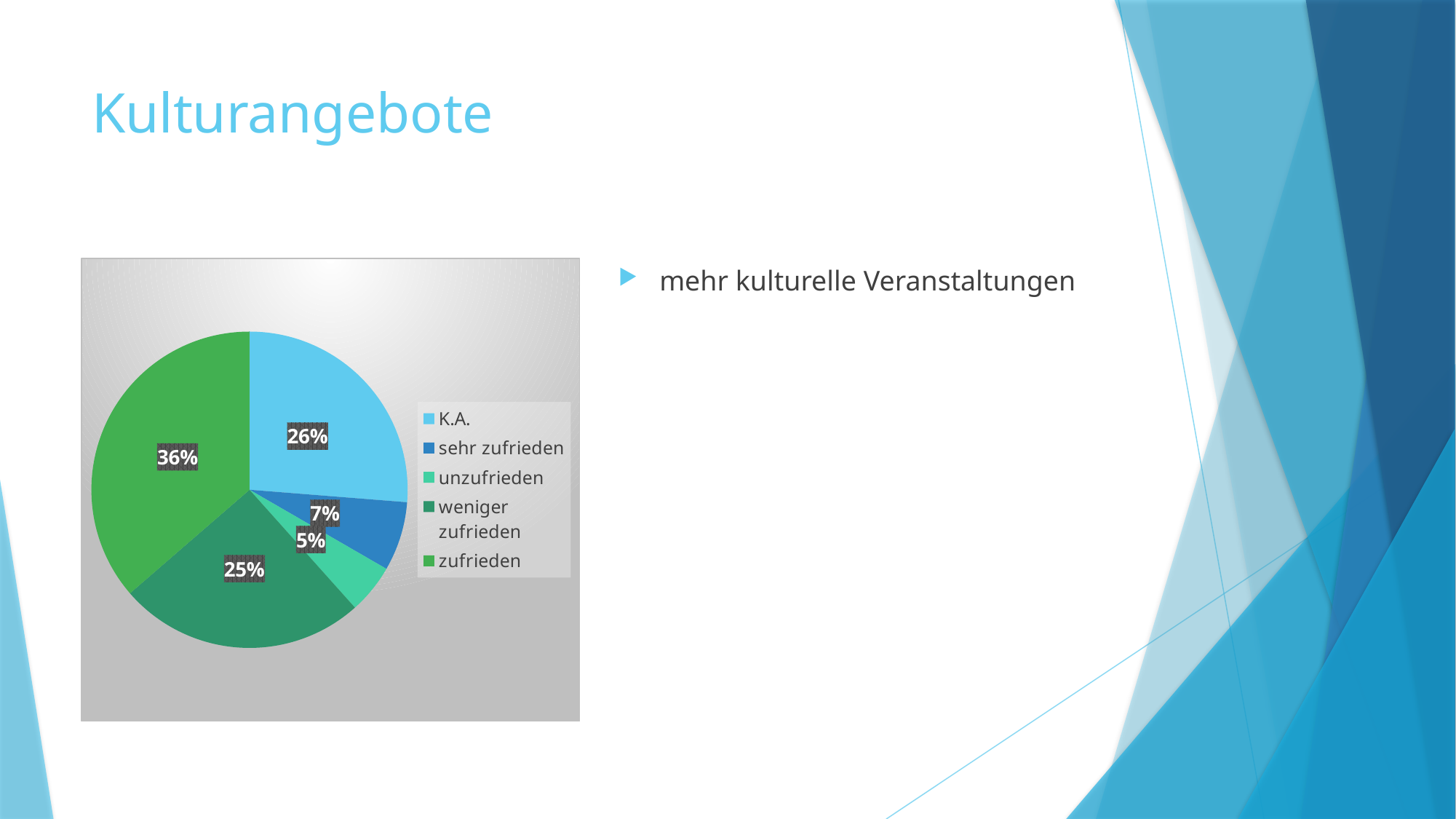
What share of the pie is labelled "weniger zufrieden"? 25% Which category has the largest slice of the pie? zufrieden What share of the pie is labelled "sehr zufrieden"? 7% Which is larger, the slice for "K.A." or the slice for "sehr zufrieden"? K.A. What is the difference in percentage points between "zufrieden" and "weniger zufrieden"? 11 What share of the pie is labelled "unzufrieden"? 5% What is the title of the slide containing the pie chart? Kulturangebote How many categories does the legend list? 5 What kind of chart is shown on the slide? pie chart What share of the pie is labelled "zufrieden"? 36% What share of the pie is labelled "K.A."? 26% Which category has the smallest slice of the pie? unzufrieden